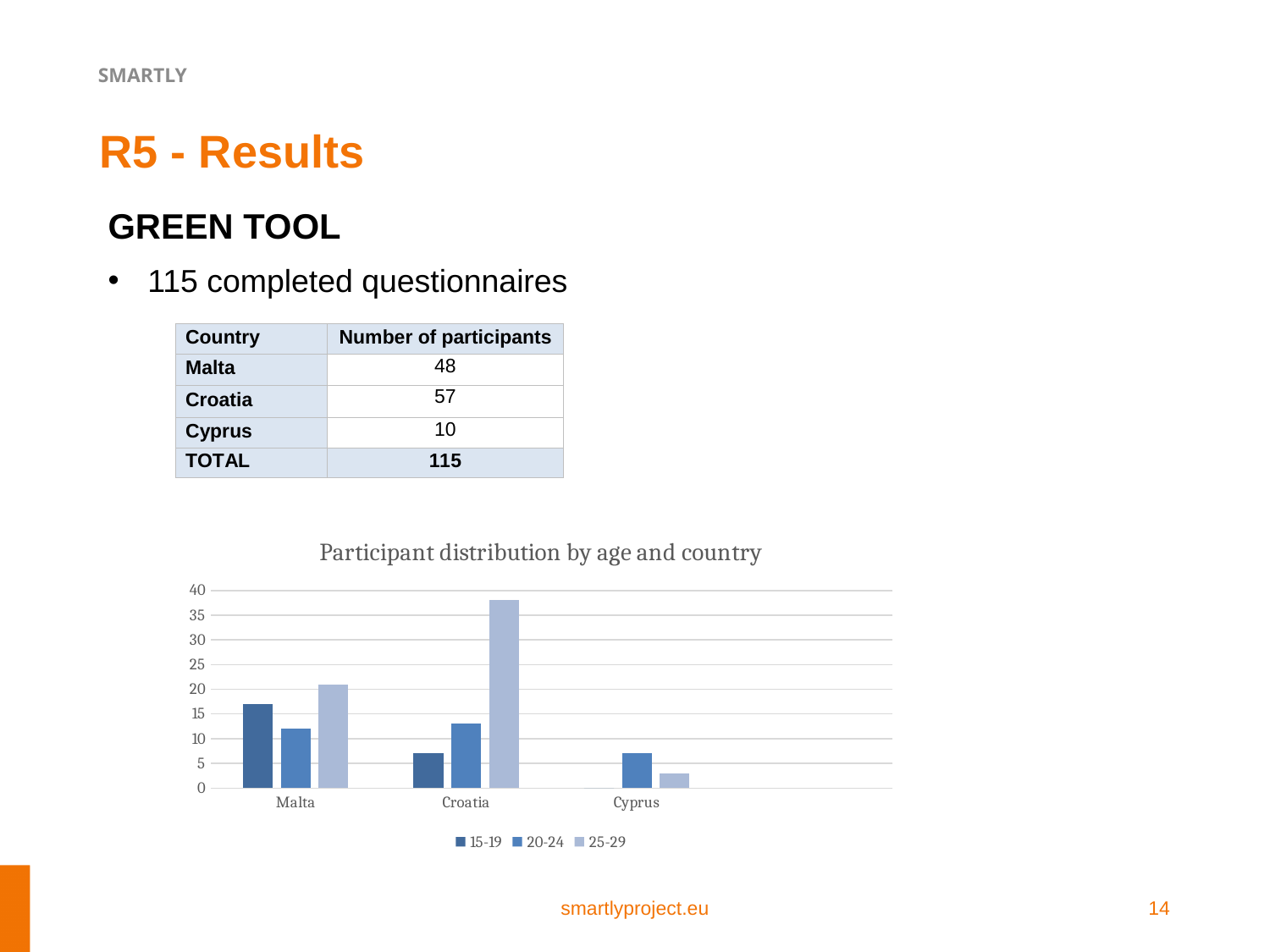
Is the value for the 25-29 age group in Cyprus greater or less than 5? less Which age group has the shortest bar for Croatia? 15-19 Is the value for the 25-29 age group in Croatia greater or less than 35? greater How many series does the chart legend list? 3 Which age group has the tallest bar for Malta? 25-29 Which is larger: the 25-29 bar for Croatia or the 25-29 bar for Malta? Croatia Which is larger: the 15-19 bar for Malta or the 15-19 bar for Croatia? Malta What is the title of the chart? Participant distribution by age and country How many countries are shown on the x axis of the chart? 3 Which age group has the tallest bar for Croatia? 25-29 Is the value for the 15-19 age group in Malta greater or less than 15? greater What kind of chart is shown on the slide? bar chart